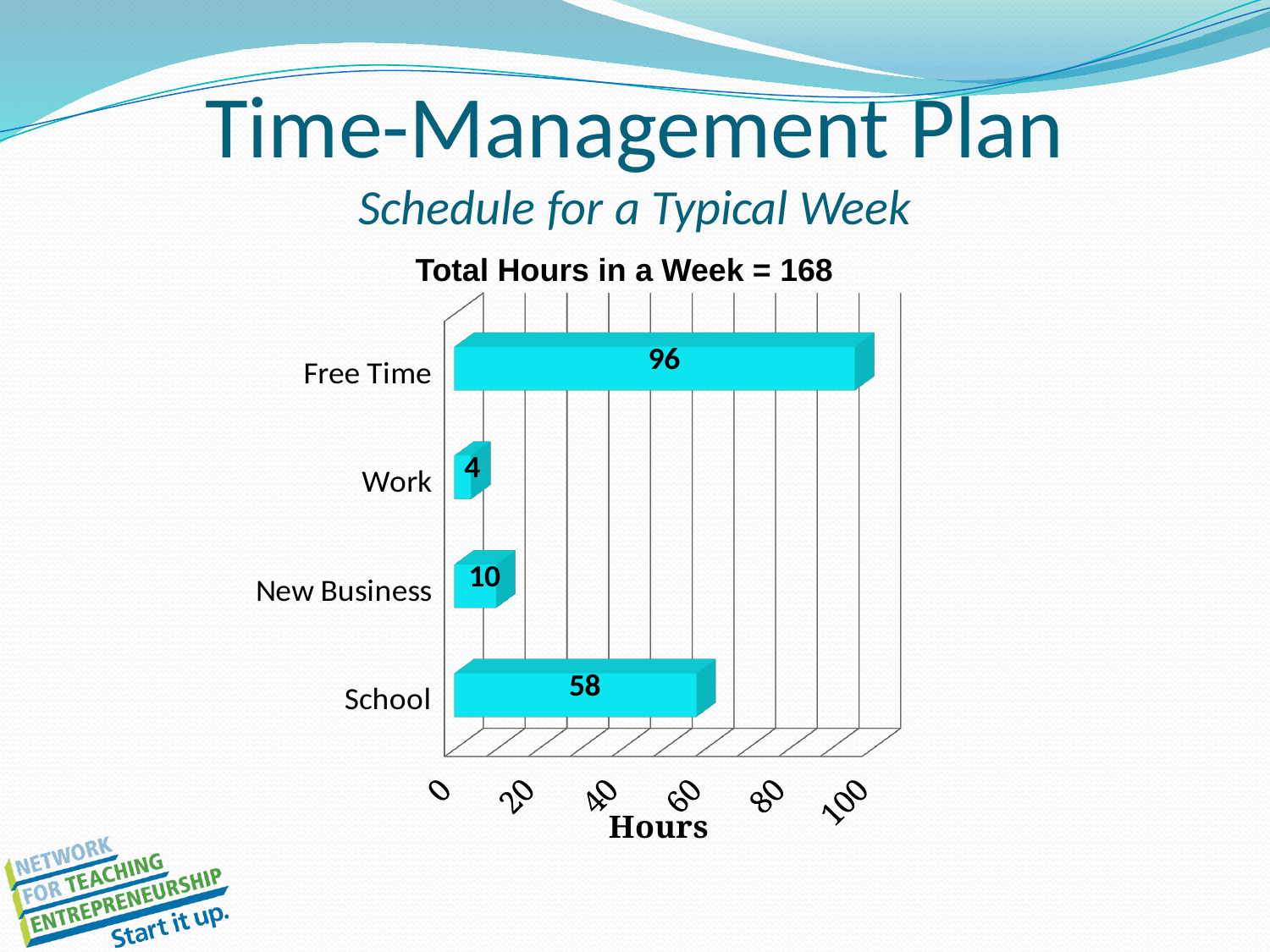
Which category has the lowest number of hours? Work What is the difference in hours between Free Time and School? 38 What is the difference in hours between New Business and Work? 6 How many hours are shown for New Business? 10 How many hours are shown for School? 58 How many categories are shown in the chart? 4 Which has more hours, School or New Business? School Which category has the highest number of hours? Free Time What kind of chart is shown on the slide? bar chart What is the title of the chart? Total Hours in a Week = 168 How many hours are shown for Free Time? 96 How many hours are shown for Work? 4